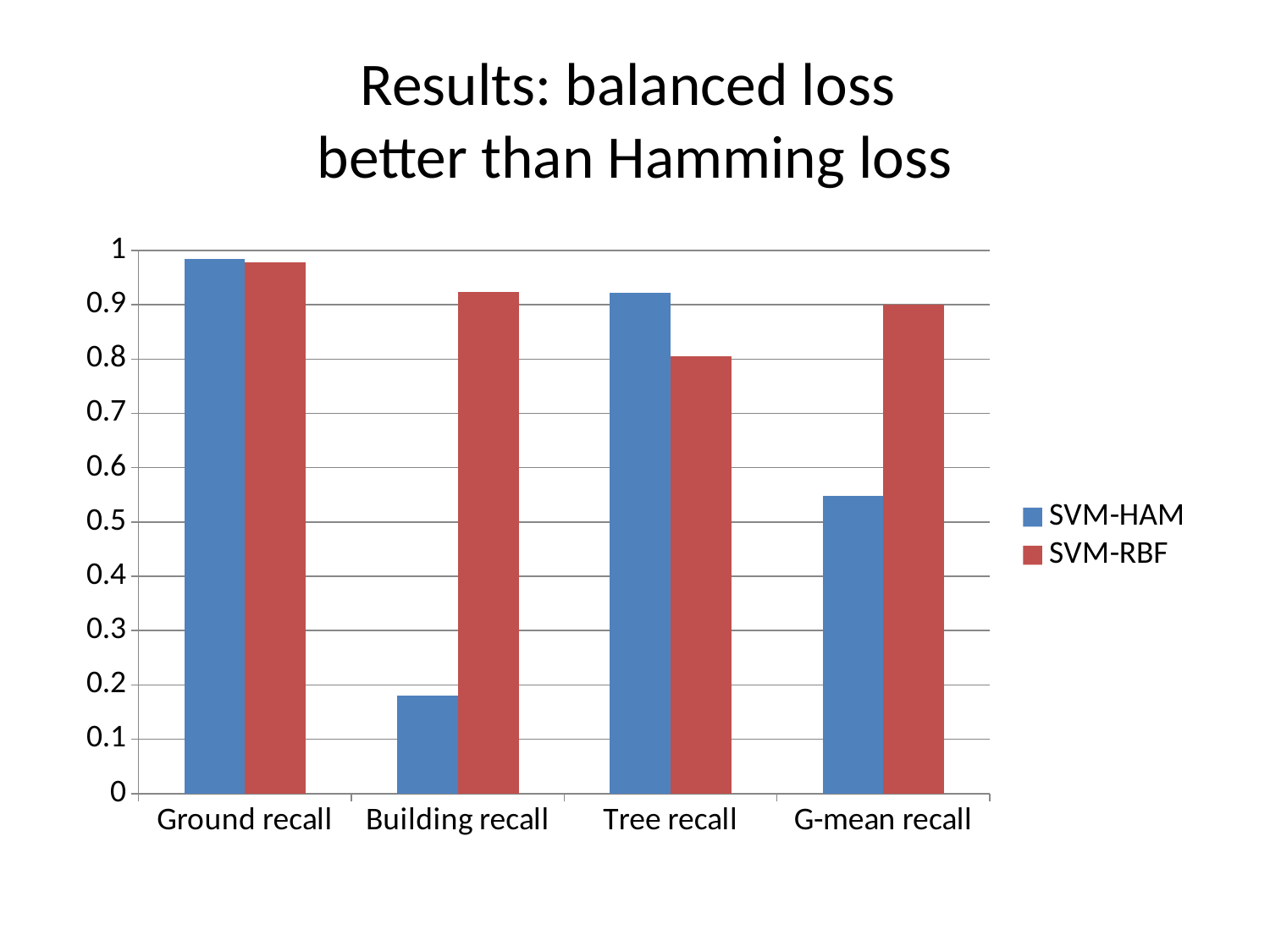
How many series does the legend list? 2 What kind of chart is shown on the slide? bar chart Is the SVM-RBF value for Tree recall greater or less than 0.7? greater Is the SVM-HAM value for Building recall greater or less than 0.3? less For Building recall, which series has the larger value, SVM-HAM or SVM-RBF? SVM-RBF For Tree recall, which series has the larger value, SVM-HAM or SVM-RBF? SVM-HAM For G-mean recall, which series has the larger value, SVM-HAM or SVM-RBF? SVM-RBF What is the title of the slide? Results: balanced loss better than Hamming loss Which category has the lowest SVM-RBF value? Tree recall Which series does the legend list first? SVM-HAM How many categories are shown on the x axis? 4 Which category has the lowest SVM-HAM value? Building recall